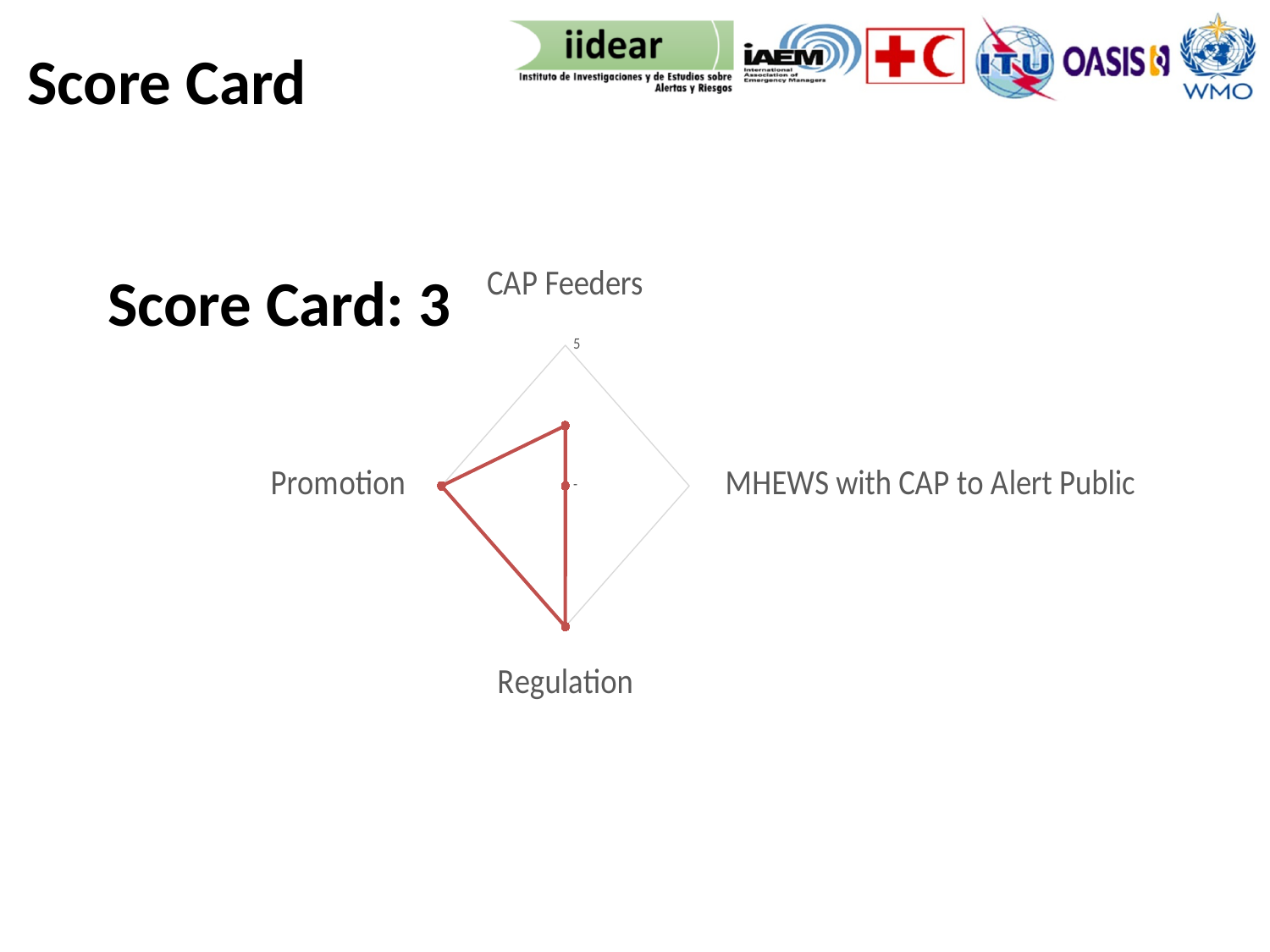
What is the value for Regulation on the radar chart? 5 Which is larger, the value for CAP Feeders or the value for MHEWS with CAP to Alert Public? CAP Feeders Which is larger, the value for Promotion or the value for MHEWS with CAP to Alert Public? Promotion Which category has the lowest value on the radar chart? MHEWS with CAP to Alert Public What kind of chart is shown on the slide? Radar chart Is the value for CAP Feeders greater or less than 5? less Which is larger, the value for Regulation or the value for CAP Feeders? Regulation What colour is the data line plotted on the radar chart? Red What is the value for Promotion on the radar chart? 5 What is the maximum value shown on the radar chart's axis? 5 How many categories (axes) does the radar chart have? 4